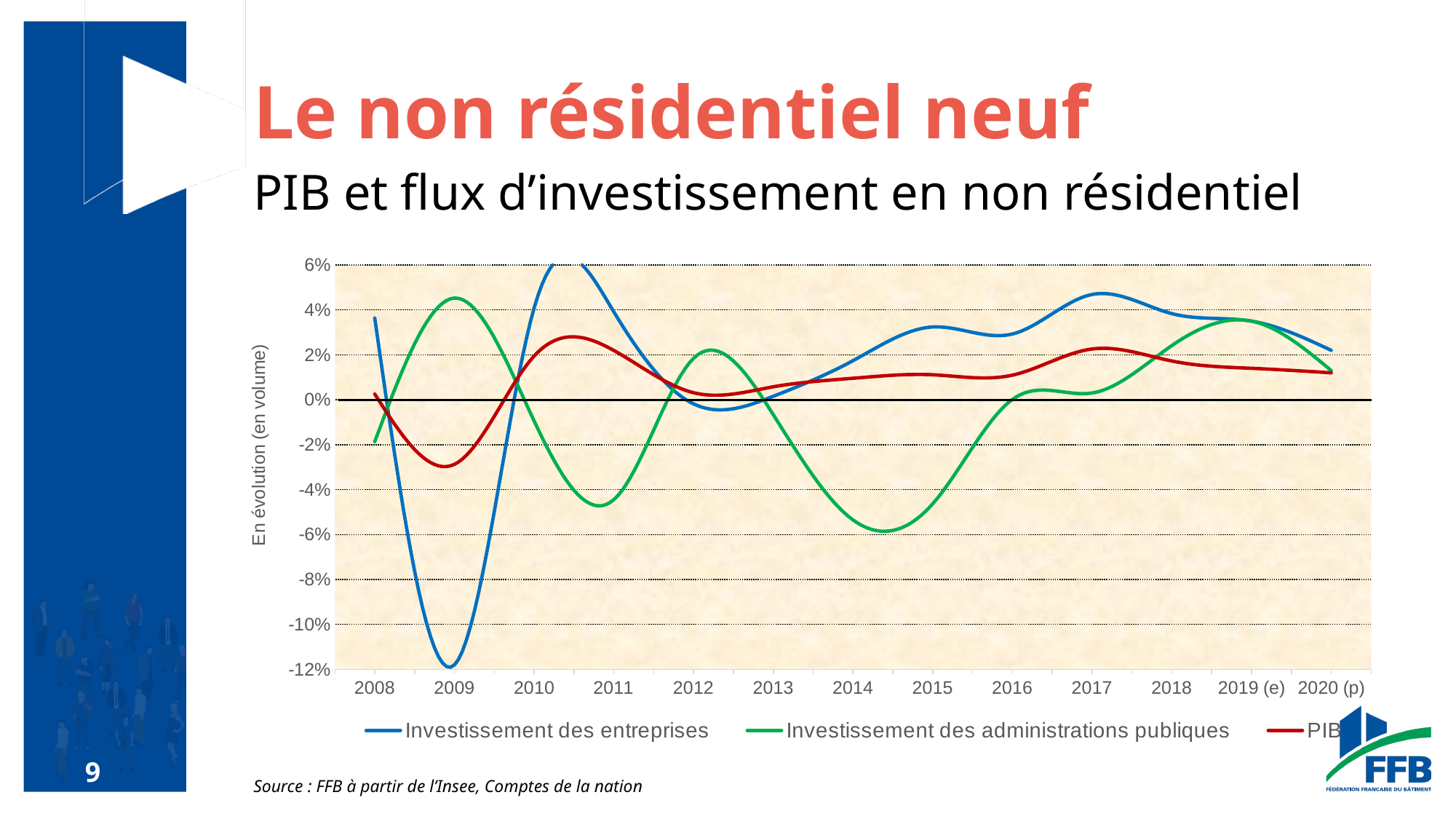
In 2009, which is larger: Investissement des entreprises or Investissement des administrations publiques? Investissement des administrations publiques Is the value for Investissement des entreprises in 2009 greater or less than -10%? less Is the value for Investissement des entreprises in 2017 greater or less than 4%? greater In 2014, which is larger: Investissement des entreprises or Investissement des administrations publiques? Investissement des entreprises How many years are shown along the x axis? 13 What kind of chart is shown on the slide? line chart In which year is the value for Investissement des entreprises highest? 2017 Does the value for Investissement des entreprises rise or fall from 2017 to 2020 (p)? fall How many series does the legend list? 3 Is the value for Investissement des administrations publiques in 2014 greater or less than -4%? less In which year is the value for PIB lowest? 2009 In which year is the value for Investissement des entreprises lowest? 2009